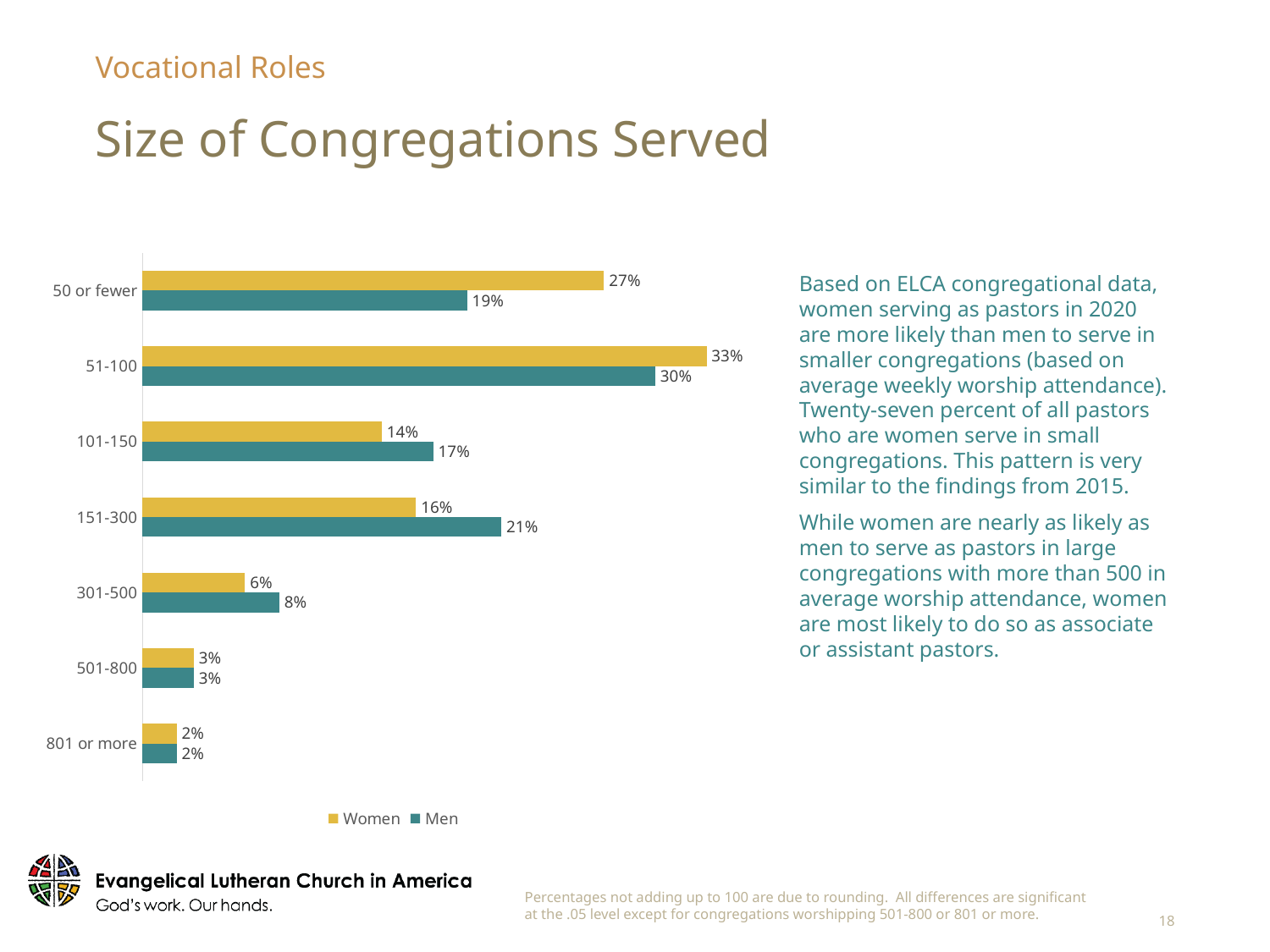
How many congregation size categories are shown on the chart? 7 Which congregation size category has the lowest value for Men? 801 or more Which congregation size category has the highest value for Women? 51-100 In the 101-150 category, which is larger, the value for Women or for Men? Men What percentage of women serve congregations of 50 or fewer? 27% What is the value for Men in the 151-300 category? 21% What is the difference between the Women and Men values for the 50 or fewer category? 8% How many series does the legend list? 2 What is the difference between the Men and Women values for the 151-300 category? 5% What percentage of men serve congregations of 51-100? 30% What kind of chart is shown on the slide? Bar chart Which series is shown in yellow? Women